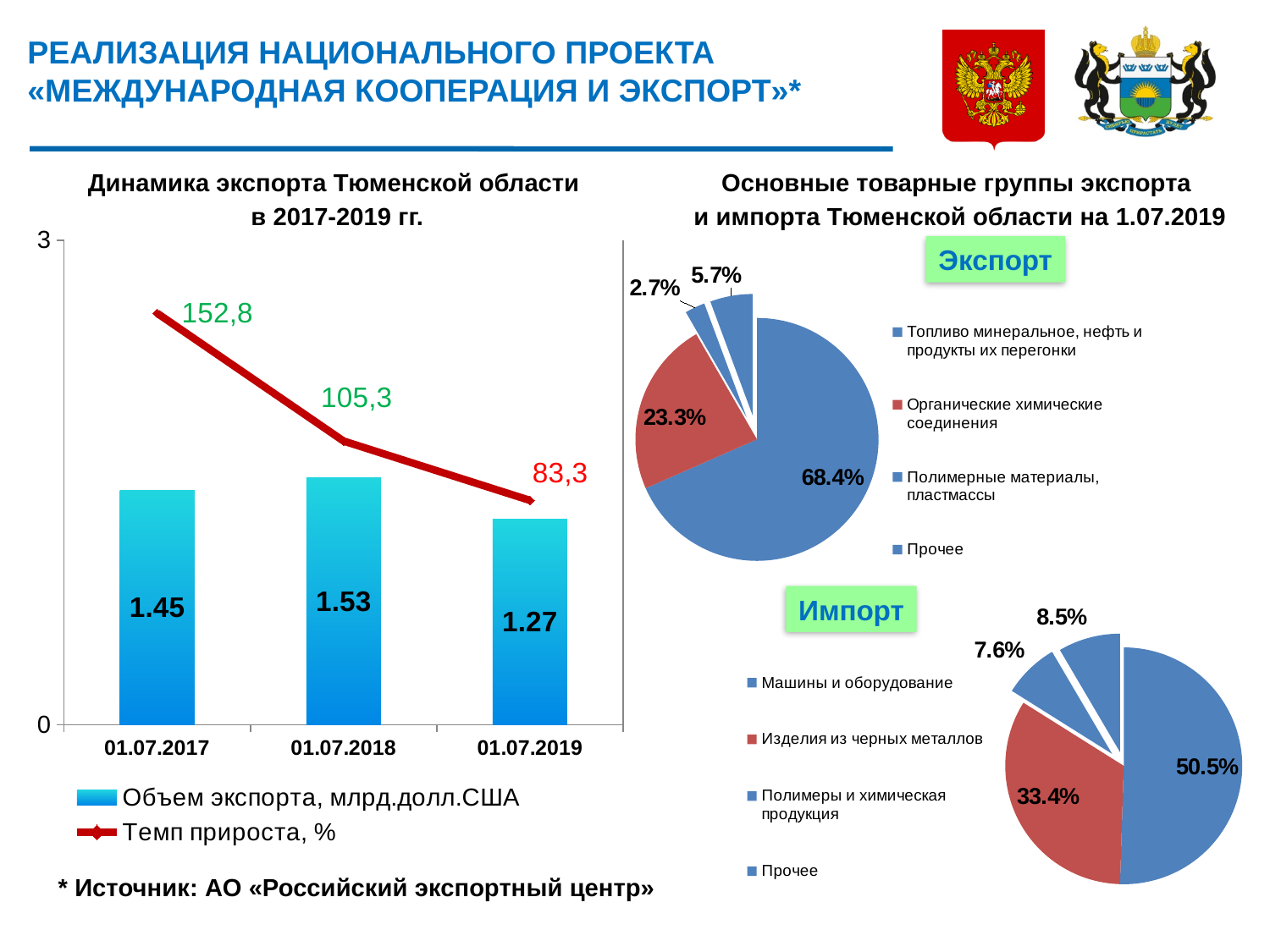
In the chart 'Динамика экспорта Тюменской области в 2017-2019 гг.', which date has the highest export volume? 01.07.2018 In the 'Экспорт' pie chart, what is the share of 'Органические химические соединения'? 23.3% In the chart 'Динамика экспорта Тюменской области в 2017-2019 гг.', what is the difference between the export volume for 01.07.2018 and 01.07.2019? 0.26 In the 'Экспорт' pie chart, which product group has the largest share? Топливо минеральное, нефть и продукты их перегонки In the chart 'Динамика экспорта Тюменской области в 2017-2019 гг.', is the growth rate for 01.07.2017 larger or smaller than for 01.07.2018? Larger How many series does the legend of the chart 'Динамика экспорта Тюменской области в 2017-2019 гг.' list? 2 In the 'Импорт' pie chart, what is the share of 'Изделия из черных металлов'? 33.4% In the chart 'Динамика экспорта Тюменской области в 2017-2019 гг.', what is the export volume (Объем экспорта) for 01.07.2018? 1.53 In the chart 'Динамика экспорта Тюменской области в 2017-2019 гг.', does the growth rate (Темп прироста, %) rise or fall from 01.07.2017 to 01.07.2019? It falls In the chart 'Динамика экспорта Тюменской области в 2017-2019 гг.', what is the growth rate (Темп прироста, %) for 01.07.2017? 152,8 How many dates are shown on the x axis of the chart 'Динамика экспорта Тюменской области в 2017-2019 гг.'? 3 In the chart 'Динамика экспорта Тюменской области в 2017-2019 гг.', which date has the lowest export volume? 01.07.2019